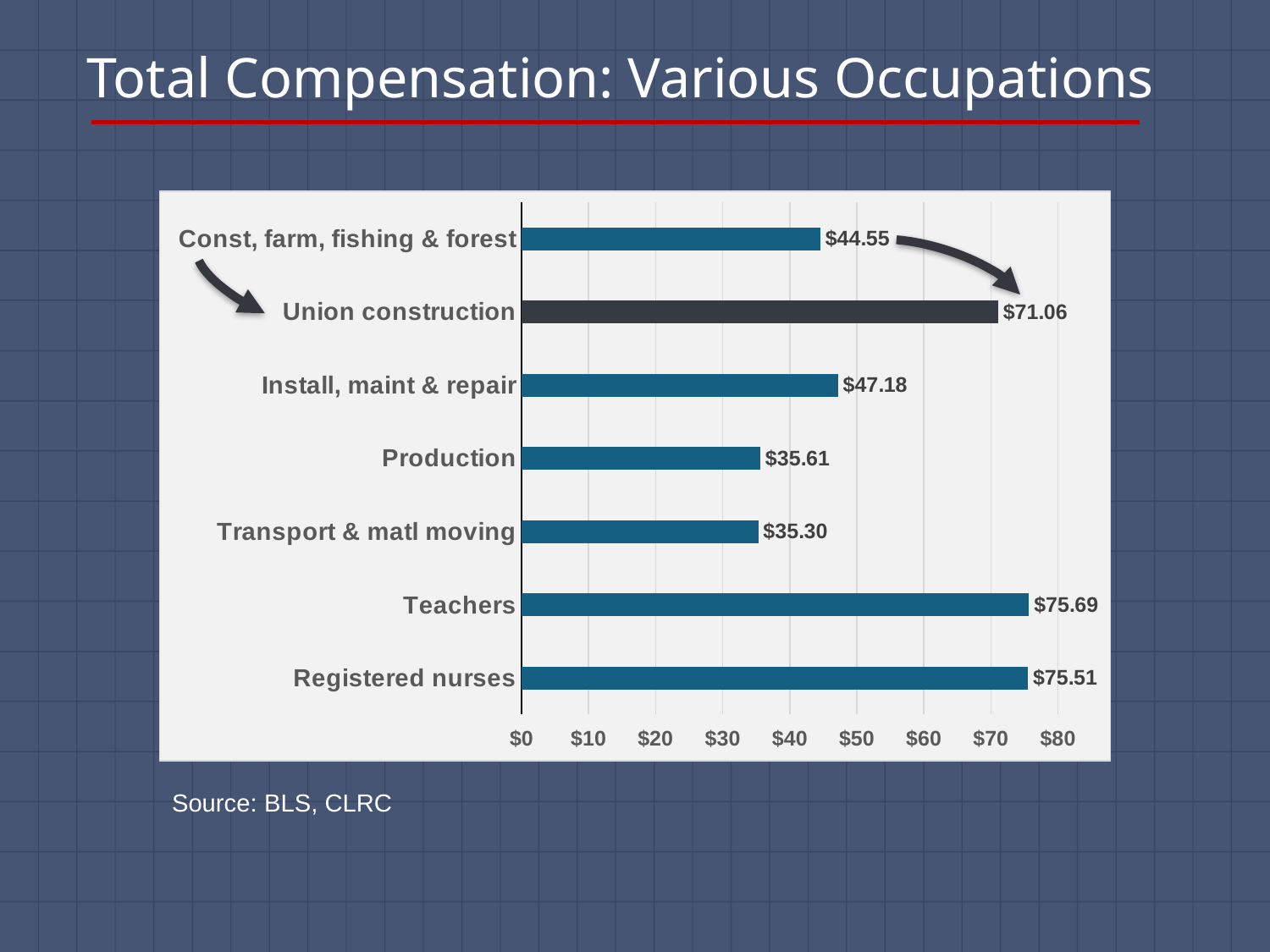
Which is larger, Union construction or Install, maint & repair? Union construction Which occupation has the lowest total compensation? Transport & matl moving Is the value for Production greater or less than $40? less How many occupations are shown in the chart? 7 What is the difference between Union construction and Const, farm, fishing & forest? $26.51 What kind of chart is shown on the slide? bar chart What is the value for Teachers? $75.69 What is the value for Install, maint & repair? $47.18 Which occupation has the highest total compensation? Teachers What is the value for Transport & matl moving? $35.30 What is the difference between Install, maint & repair and Production? $11.57 What is the value for Union construction? $71.06